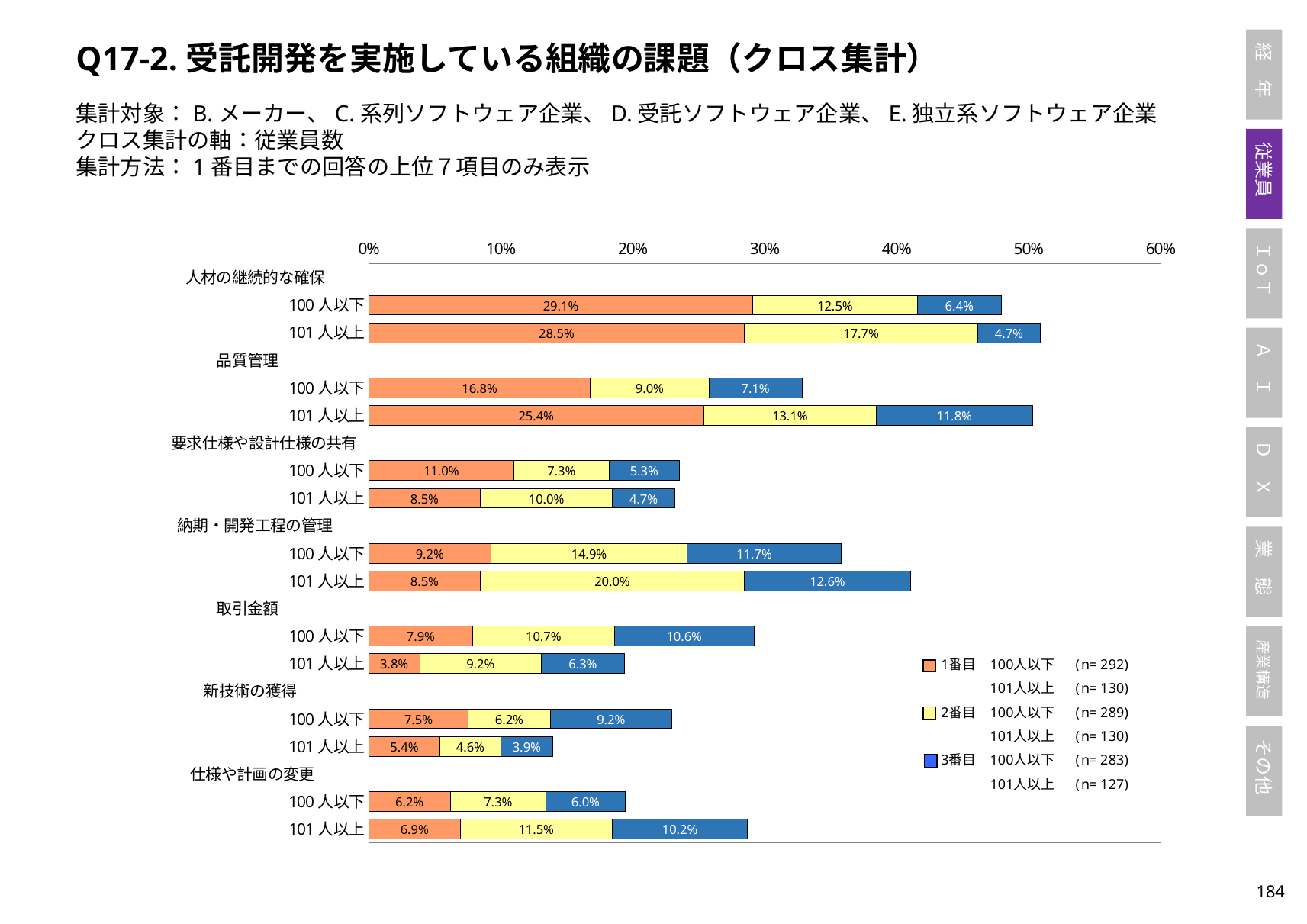
What is the 3番目 value for 品質管理 among 101人以上 organizations? 11.8% What is the 2番目 value for 納期・開発工程の管理 among 101人以上 organizations? 20.0% For 品質管理, is the 2番目 value larger for 100人以下 or 101人以上? 101人以上 What is the total of the stacked bar for 品質管理, 101人以上? 50.3% What is the difference between the 1番目 values for 品質管理 between 101人以上 and 100人以下? 8.6 percentage points What kind of chart is shown on the slide? Stacked bar chart How many challenge categories are shown on the chart? 7 How many series does the legend list? 3 What is the 1番目 value for 人材の継続的な確保 among 100人以下 organizations? 29.1% Which category has the highest 1番目 value? 人材の継続的な確保 (100人以下) Which bar has the lowest 1番目 value? 取引金額, 101人以上 What is the total of the stacked bar for 人材の継続的な確保, 100人以下? 48.0%